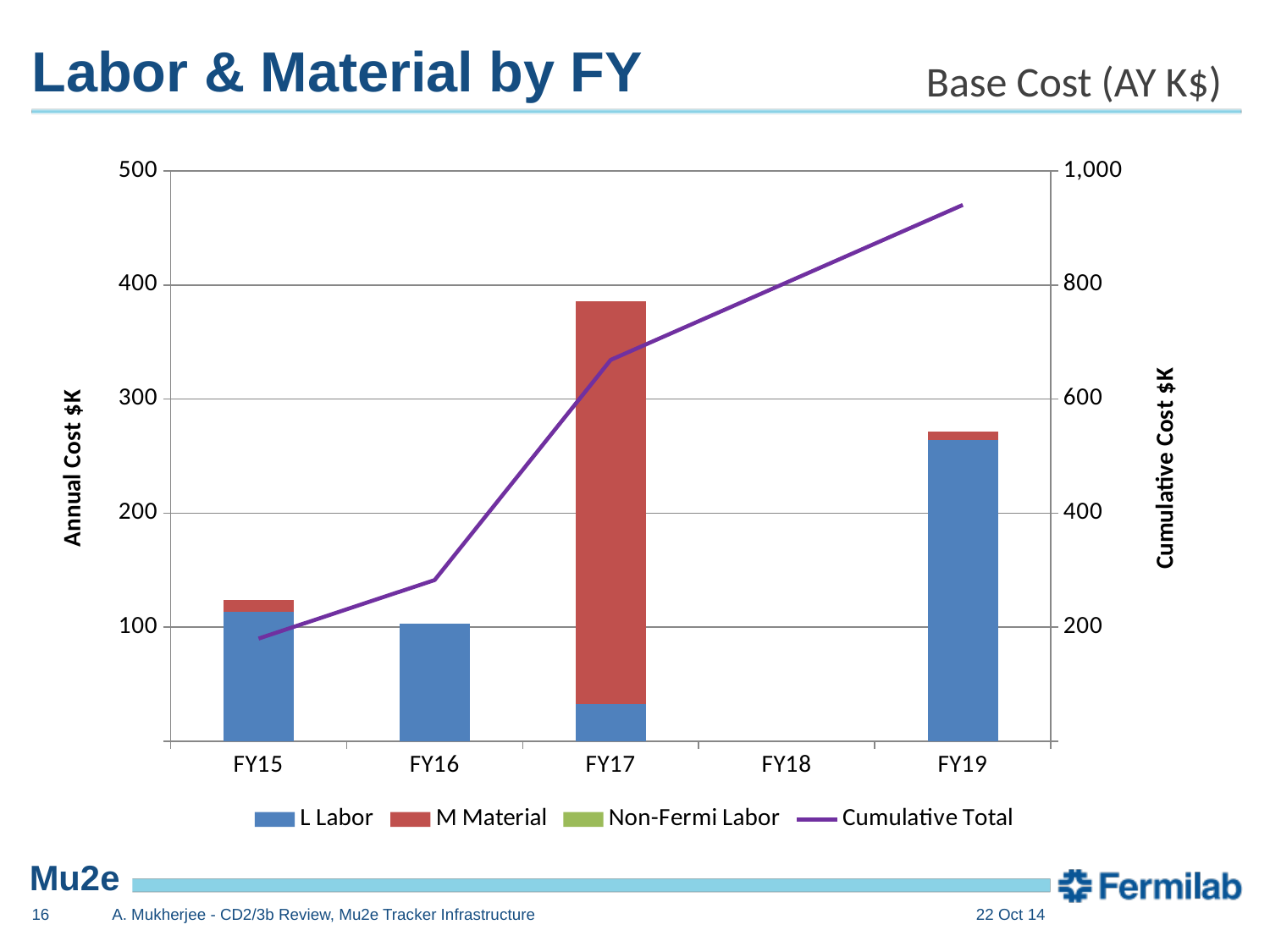
How many fiscal years are shown on the x axis? 5 What is the title of the right-hand vertical axis? Cumulative Cost $K Is the total bar height for FY16 greater or less than 200 on the Annual Cost axis? less How many series does the legend list? 4 Which has the taller stacked bar, FY16 or FY19? FY19 Is the Cumulative Total at FY15 greater or less than 200 on the Cumulative Cost axis? less Is the total bar height for FY17 greater or less than 300 on the Annual Cost axis? greater Which fiscal year shows no bar at all? FY18 Which fiscal year has the tallest stacked bar? FY17 What kind of chart is shown on the slide? A combination chart of stacked bars and a line Does the Cumulative Total line rise or fall from FY15 to FY19? rise